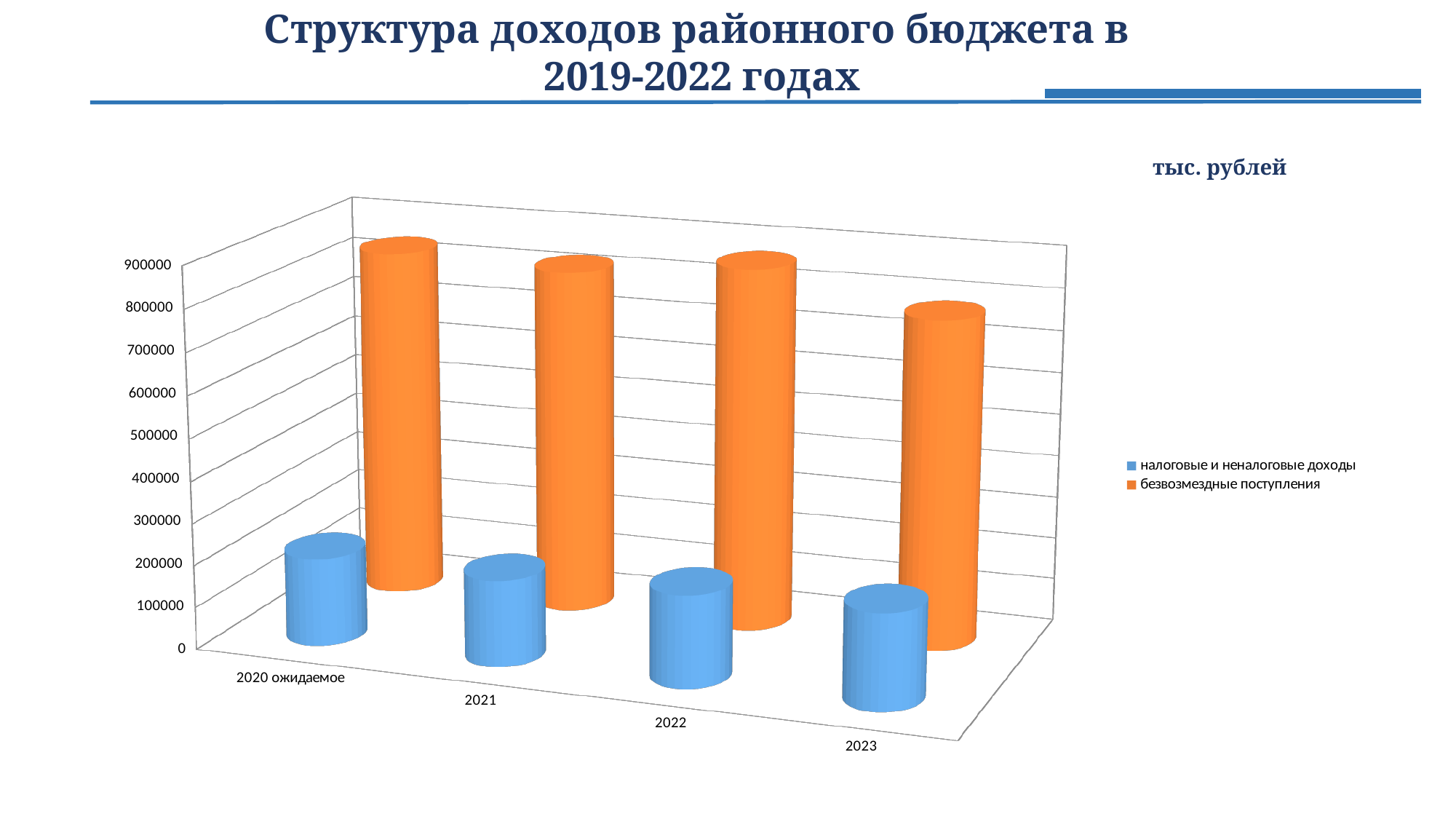
Is the value of безвозмездные поступления for 2023 greater or less than 400000? greater Is the value of налоговые и неналоговые доходы for 2020 ожидаемое greater or less than 400000? less What unit of measurement is indicated above the chart? тыс. рублей What kind of chart is shown on the slide? bar chart How many categories are shown along the x axis of the chart? 4 Which series is shown in orange in the chart? безвозмездные поступления For 2021, which is larger: налоговые и неналоговые доходы or безвозмездные поступления? безвозмездные поступления Is the value of безвозмездные поступления for 2022 greater or less than 500000? greater For 2023, which is larger: налоговые и неналоговые доходы or безвозмездные поступления? безвозмездные поступления How many series does the chart legend list? 2 What is the label of the first category on the x axis of the chart? 2020 ожидаемое